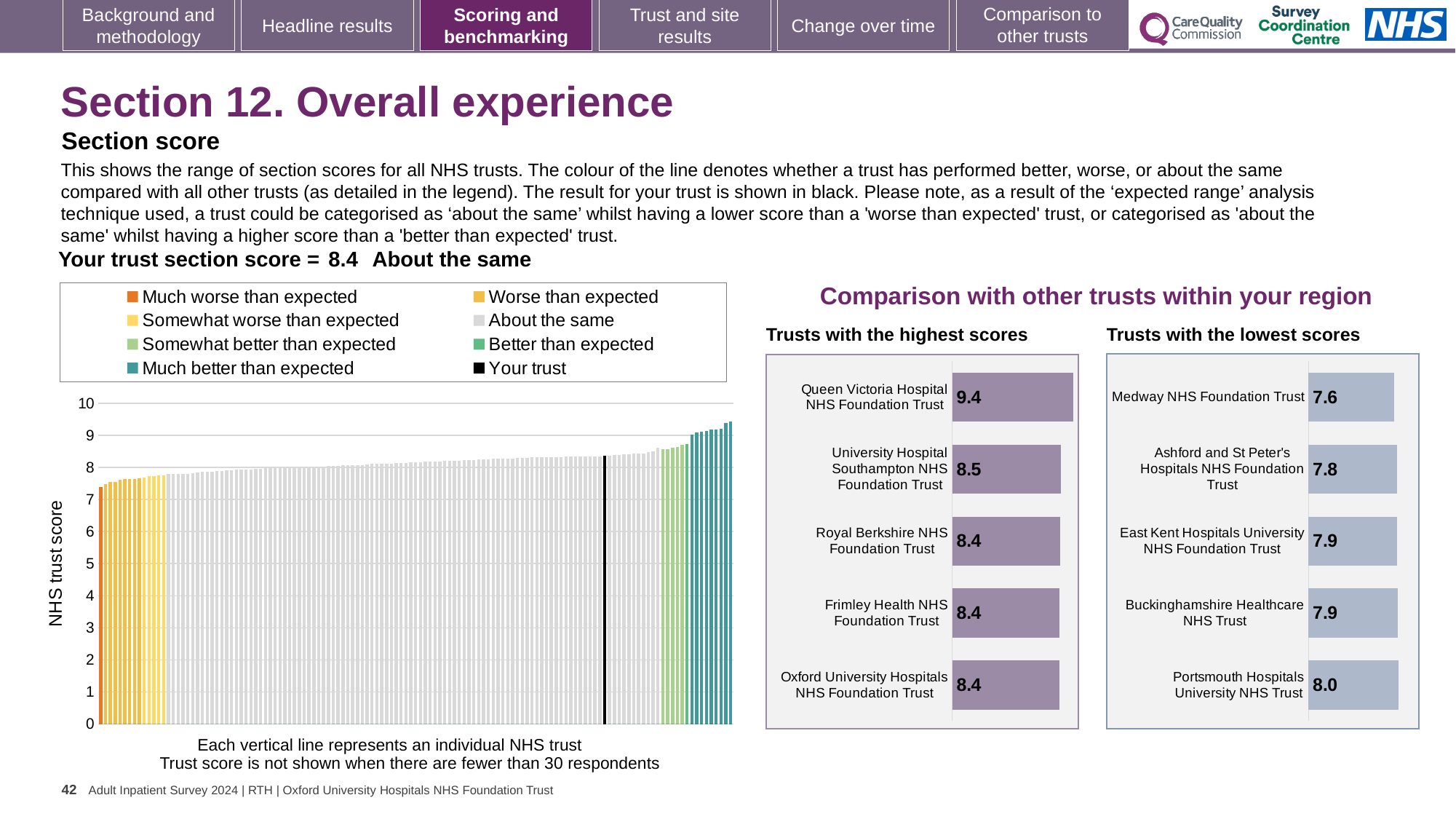
In the 'Trusts with the highest scores' chart, which trust has the highest score? Queen Victoria Hospital NHS Foundation Trust In the 'Trusts with the lowest scores' chart, what is the score for Medway NHS Foundation Trust? 7.6 How many entries does the legend of the large chart on the left list? 8 In the 'Trusts with the highest scores' chart, what is the score for University Hospital Southampton NHS Foundation Trust? 8.5 In the 'Trusts with the lowest scores' chart, what is the score for Portsmouth Hospitals University NHS Trust? 8.0 In the 'Trusts with the highest scores' chart, what is the difference between the scores of Queen Victoria Hospital NHS Foundation Trust and University Hospital Southampton NHS Foundation Trust? 0.9 In the 'Trusts with the lowest scores' chart, which has the larger score: Medway NHS Foundation Trust or Ashford and St Peter's Hospitals NHS Foundation Trust? Ashford and St Peter's Hospitals NHS Foundation Trust In the large chart on the left showing all NHS trusts, is the value for the leftmost (orange) bar greater or less than 8? less In the large chart on the left showing all NHS trusts, do the values rise or fall from left to right along the x axis? rise In the 'Trusts with the lowest scores' chart, how many trusts are shown? 5 In the 'Trusts with the highest scores' chart, what is the score for Queen Victoria Hospital NHS Foundation Trust? 9.4 In the 'Trusts with the lowest scores' chart, which trust has the lowest score? Medway NHS Foundation Trust